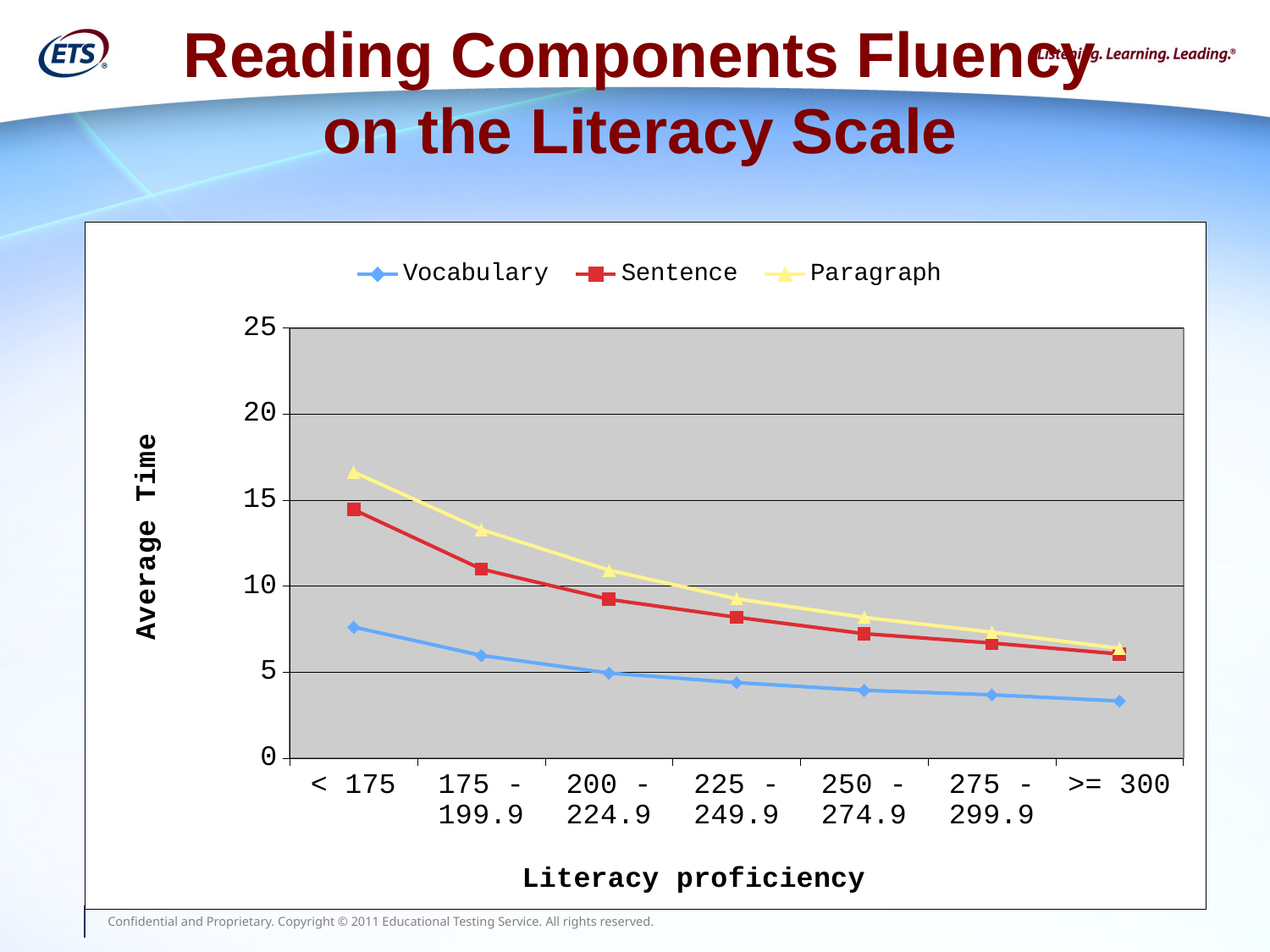
How many series does the legend list? 3 Is the Paragraph value for the < 175 category greater or less than 15? greater Is the Vocabulary value for the < 175 category greater or less than 5? greater Do the Vocabulary values rise or fall as literacy proficiency increases along the x axis? fall What kind of chart is shown on the slide? line chart Is the Sentence value for the 175 - 199.9 category greater or less than 10? greater For the < 175 category, which is larger: the Paragraph value or the Vocabulary value? Paragraph Which literacy proficiency category has the lowest Sentence value? >= 300 How many literacy proficiency categories are shown on the x axis? 7 What is the title of the vertical axis? Average Time Which literacy proficiency category has the highest Paragraph value? < 175